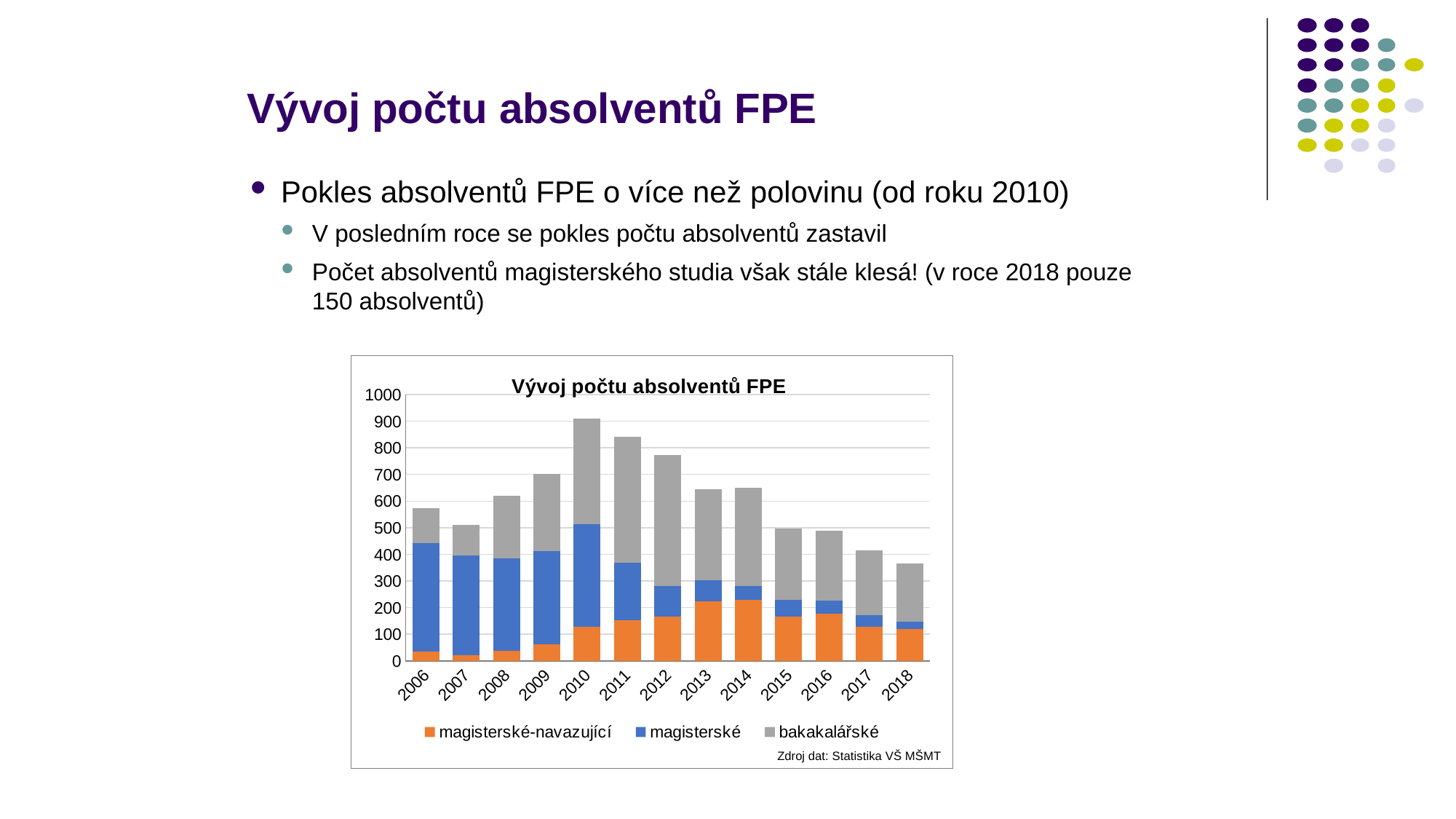
What kind of chart is shown on the slide? Stacked bar chart Do the total bar heights rise or fall from 2010 to 2018? fall Which year has the lowest total number of graduates in the chart? 2018 Which year has a larger total bar, 2006 or 2007? 2006 What is the title of the chart? Vývoj počtu absolventů FPE How many series does the chart legend list? 3 Which series is shown in grey in the chart legend? bakakalářské Is the total bar height for 2018 greater or less than 400? less How many years are shown on the x axis of the chart? 13 Is the total bar height for 2006 greater or less than 500? greater Which year has the highest total number of graduates in the chart? 2010 Is the total bar height for 2012 greater or less than 700? greater